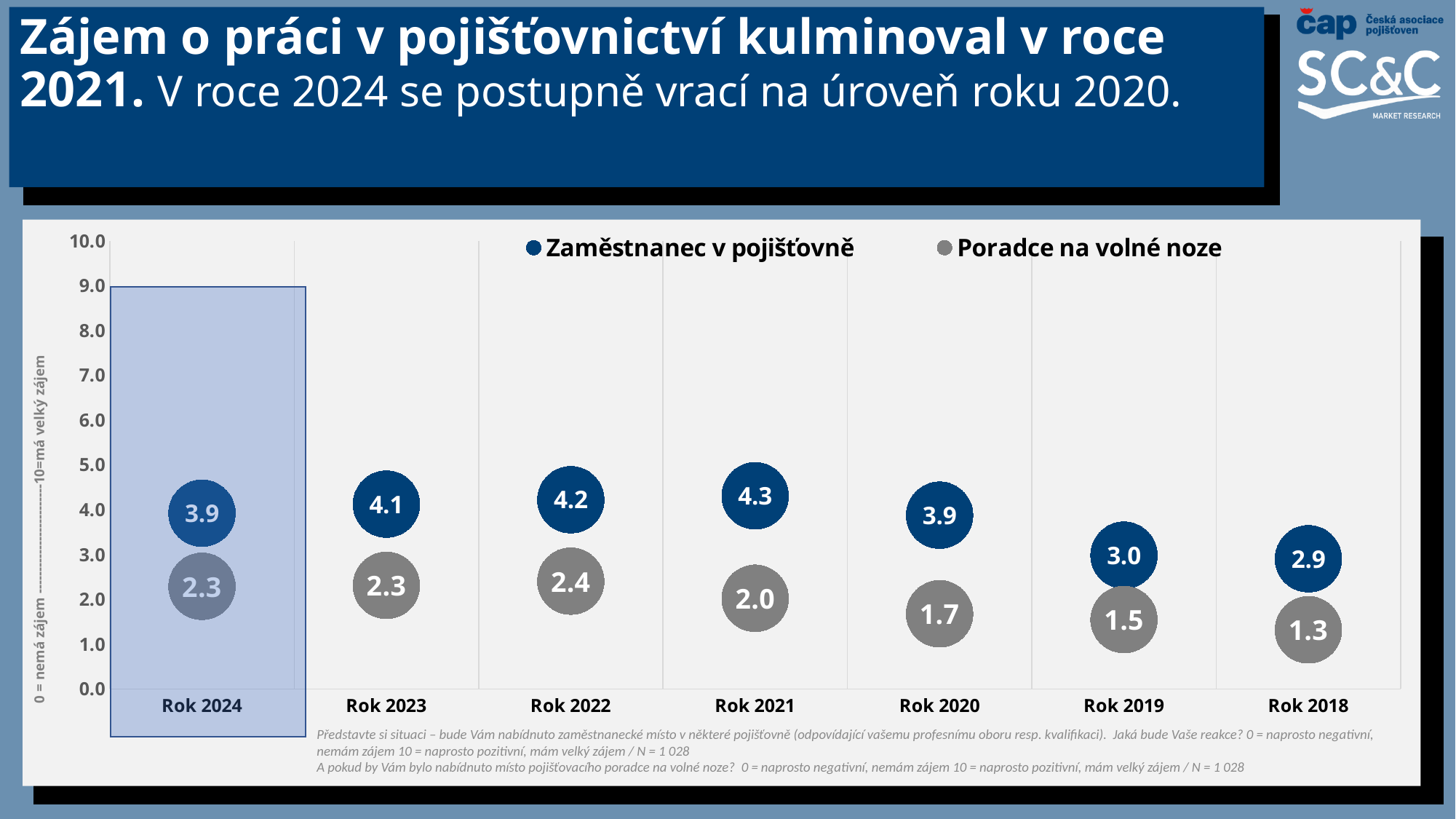
Which is larger: the Zaměstnanec v pojišťovně value in Rok 2023 or in Rok 2019? Rok 2023 Is the value for Zaměstnanec v pojišťovně in Rok 2022 greater or less than 5.0? less How many years are shown on the x axis? 7 Reading from Rok 2018 to Rok 2021, do the Poradce na volné noze values rise or fall? rise What is the difference between the Zaměstnanec v pojišťovně and Poradce na volné noze values in Rok 2020? 2.2 What is the value for Poradce na volné noze in Rok 2018? 1.3 In which year is the value for Poradce na volné noze lowest? Rok 2018 What is the value for Poradce na volné noze in Rok 2022? 2.4 How many series does the legend list? 2 What is the value for Zaměstnanec v pojišťovně in Rok 2021? 4.3 Which colour represents the series Poradce na volné noze? grey In which year is the value for Zaměstnanec v pojišťovně highest? Rok 2021